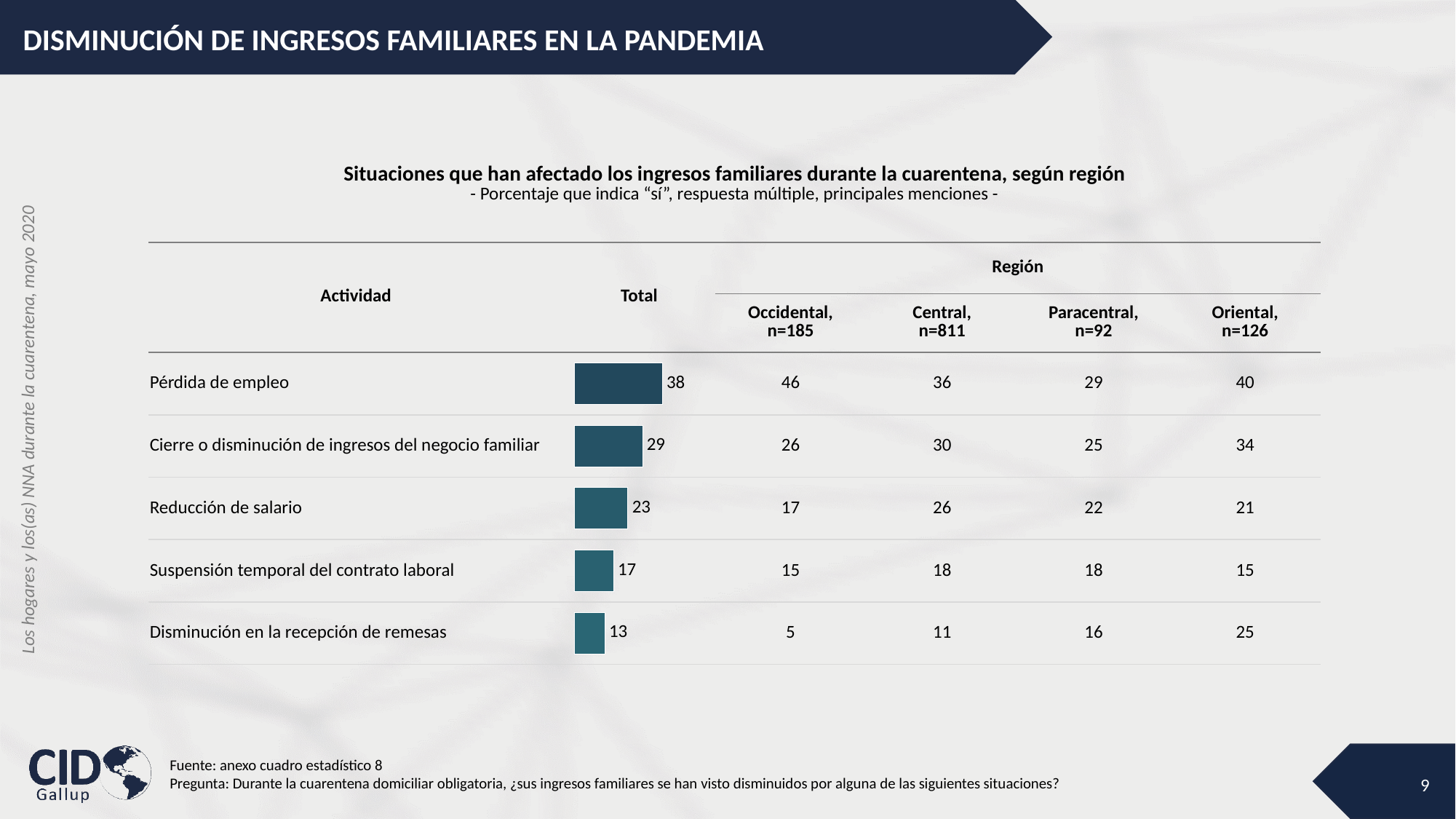
Which has a larger Total value: Reducción de salario or Suspensión temporal del contrato laboral? Reducción de salario What type of chart is used to show the Total column values? bar chart How many activities (bars) are shown in the Total bar chart? 5 Which activity has the lowest Total value? Disminución en la recepción de remesas Do the Total bar values rise or fall going down the list of activities? fall What is the Total value for Reducción de salario? 23 What is the difference between the Total values for Suspensión temporal del contrato laboral and Disminución en la recepción de remesas? 4 What is the Total value for Pérdida de empleo? 38 What is the Total value for Disminución en la recepción de remesas? 13 What is the title of the chart/table on the slide? Situaciones que han afectado los ingresos familiares durante la cuarentena, según región Which activity has the highest Total value? Pérdida de empleo What is the difference between the Total values for Pérdida de empleo and Cierre o disminución de ingresos del negocio familiar? 9